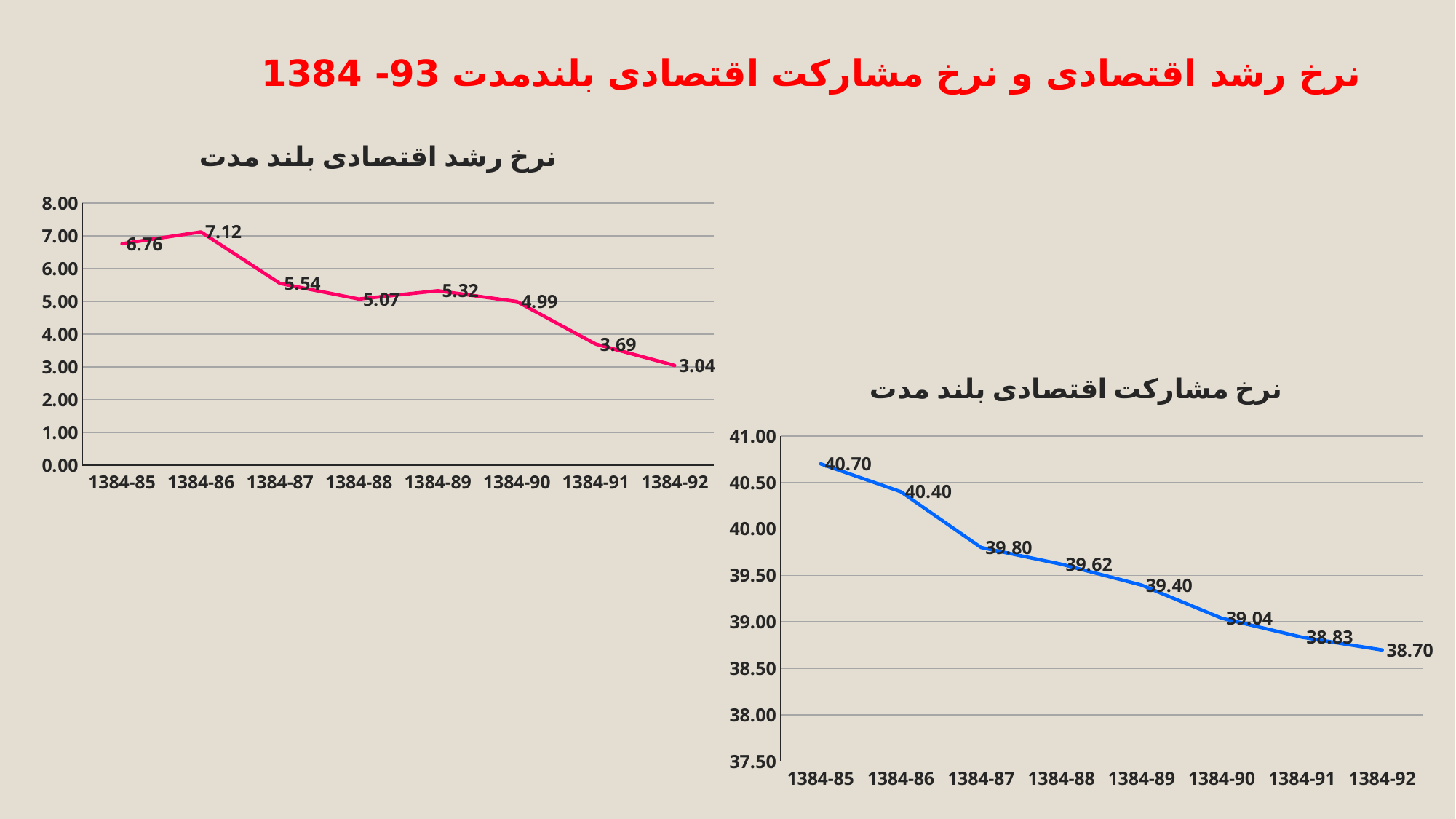
In the right chart (نرخ مشارکت اقتصادی بلند مدت), what is the difference between the values for 1384-85 and 1384-92? 2.00 In the right chart (نرخ مشارکت اقتصادی بلند مدت), do the values rise or fall from 1384-85 to 1384-92? fall In the left chart (نرخ رشد اقتصادی بلند مدت), what is the value for 1384-86? 7.12 In the left chart (نرخ رشد اقتصادی بلند مدت), how many data points are plotted? 8 In the left chart (نرخ رشد اقتصادی بلند مدت), which period has the lowest value? 1384-92 In the left chart (نرخ رشد اقتصادی بلند مدت), what is the difference between the values for 1384-86 and 1384-92? 4.08 In the right chart (نرخ مشارکت اقتصادی بلند مدت), which period has the lowest value? 1384-92 In the right chart (نرخ مشارکت اقتصادی بلند مدت), what is the value for 1384-89? 39.40 What type of chart is the right chart (نرخ مشارکت اقتصادی بلند مدت)? line chart In the left chart (نرخ رشد اقتصادی بلند مدت), which period has the highest value? 1384-86 In the right chart (نرخ مشارکت اقتصادی بلند مدت), what is the value for 1384-85? 40.70 In the left chart (نرخ رشد اقتصادی بلند مدت), what is the value for 1384-92? 3.04